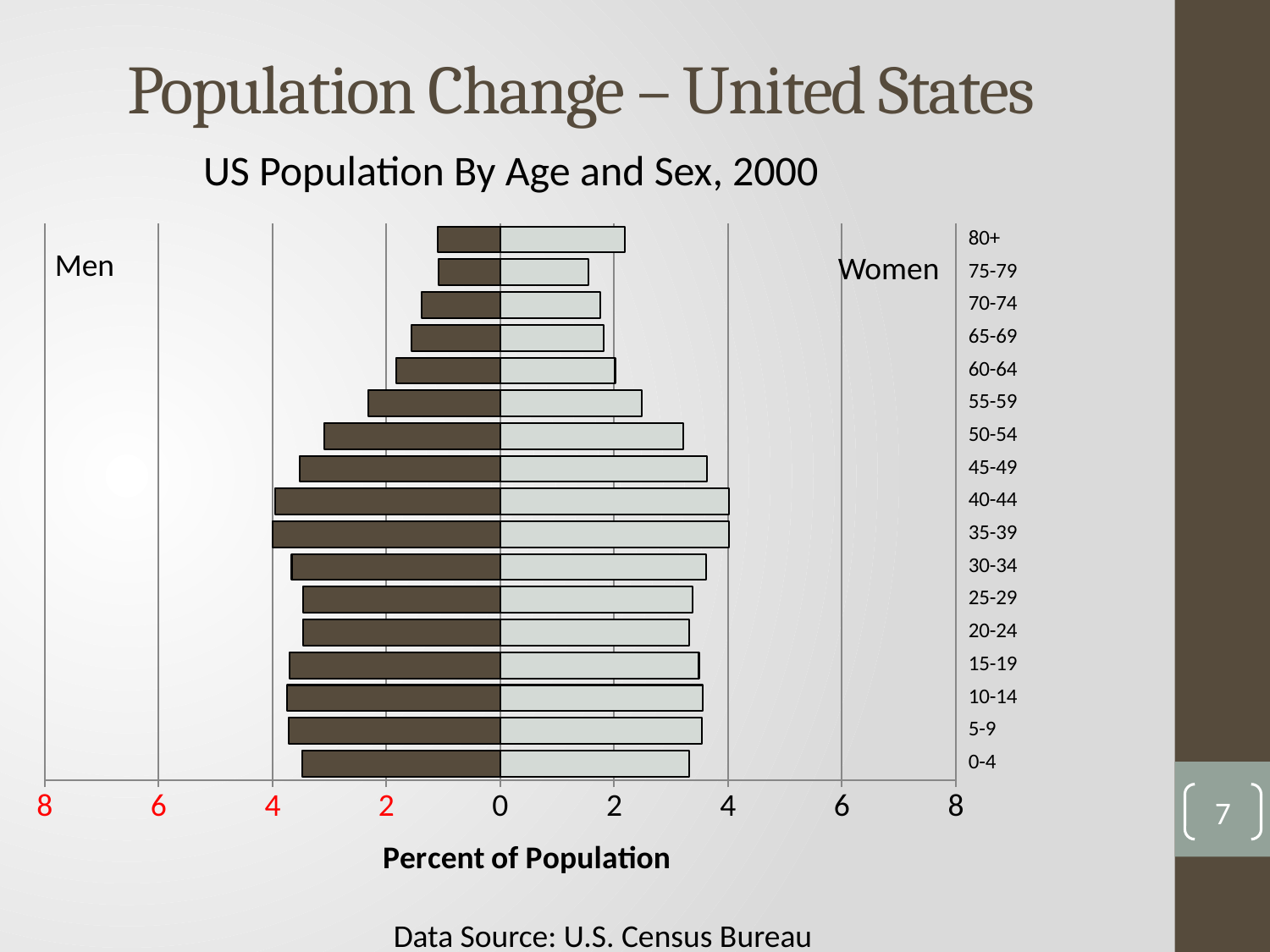
How many age groups are shown on the chart? 17 Is the value for men aged 70-74 greater or less than 2? less Which age group has the shortest bar for women? 75-79 What kind of chart is shown on the slide? bar chart Is the value for women aged 45-49 greater or less than 2? greater What is the title of the chart? US Population By Age and Sex, 2000 What is the label on the horizontal axis of the chart? Percent of Population Is the value for women aged 0-4 greater or less than 4? less For the 80+ age group, which is larger, the value for men or the value for women? women How many series (sexes) does the chart plot? 2